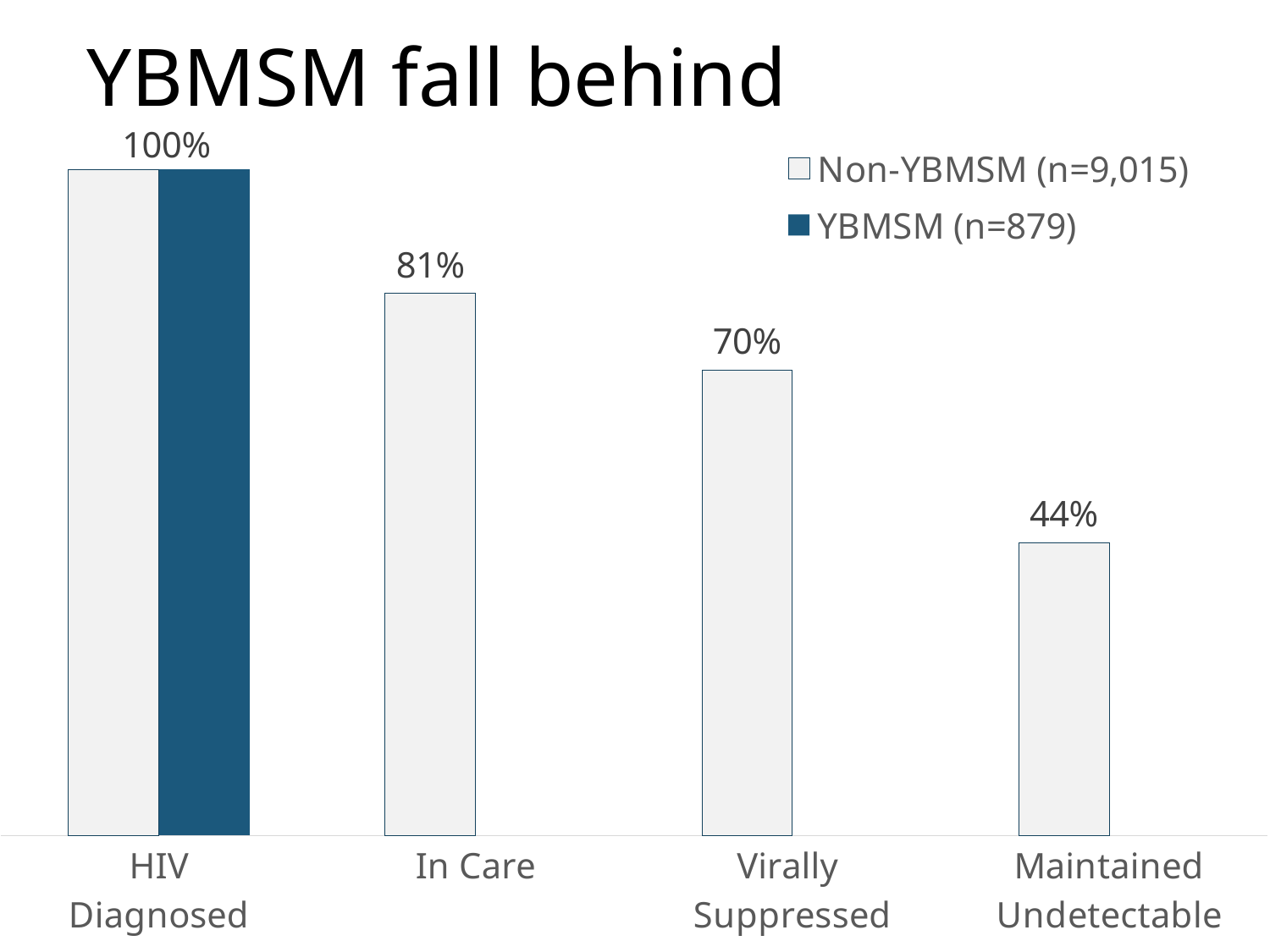
What is the Non-YBMSM value for Virally Suppressed? 70% Which is larger for Non-YBMSM: Virally Suppressed or Maintained Undetectable? Virally Suppressed How many categories are shown along the x axis? 4 How many series does the legend list? 2 Do the Non-YBMSM values rise or fall from left to right along the x axis? Fall Which category has the lowest Non-YBMSM value? Maintained Undetectable What kind of chart is shown on the slide? Bar chart What is the difference between the Non-YBMSM values for In Care and Virally Suppressed? 11 percentage points What is the Non-YBMSM value for In Care? 81% What is the title of the chart on the slide? YBMSM fall behind What is the Non-YBMSM value for Maintained Undetectable? 44% Which category has the highest value? HIV Diagnosed